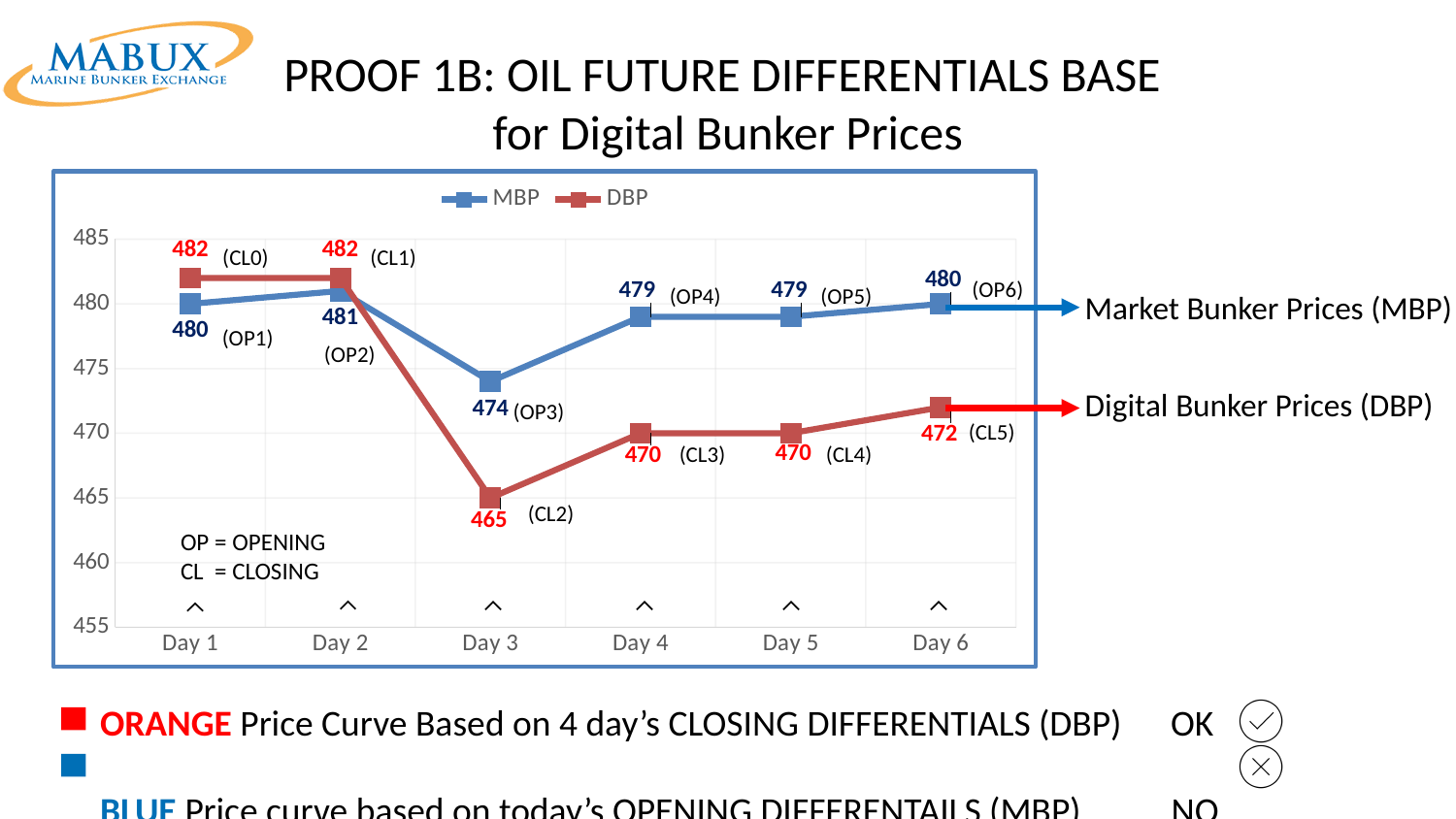
How many series does the legend list? 2 What is the difference between the DBP values on Day 2 and Day 3? 17 On which day is the DBP value lowest? Day 3 What is the MBP value on Day 3? 474 On which day is the MBP value lowest? Day 3 Does the DBP series rise or fall from Day 3 to Day 6? Rise What is the DBP value on Day 6? 472 What is the difference between the MBP and DBP values on Day 3? 9 On Day 4, which series has the higher value, MBP or DBP? MBP What kind of chart is shown on the slide? Line chart How many days are shown on the x axis? 6 What is the DBP value on Day 1? 482